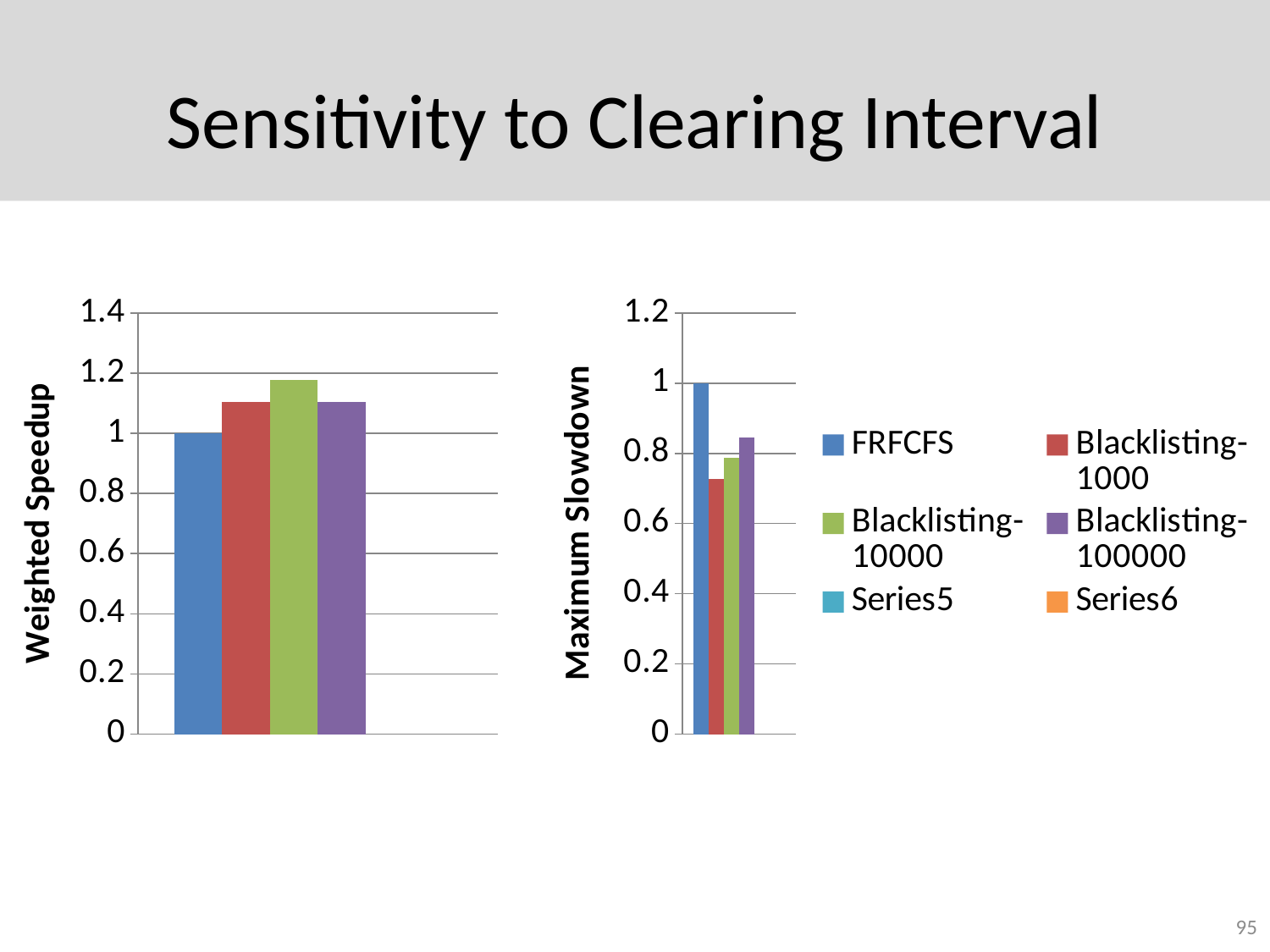
What kind of chart is the Weighted Speedup chart on the left? bar chart In the Maximum Slowdown chart on the right, which is larger, the value for FRFCFS or the value for Blacklisting-10000? FRFCFS In the Maximum Slowdown chart on the right, which series has the lowest value? Blacklisting-1000 In the Weighted Speedup chart on the left, which series has the highest value? Blacklisting-10000 In the Maximum Slowdown chart on the right, is the value for Blacklisting-1000 greater or less than 0.6? greater In the Weighted Speedup chart on the left, which series has the lowest value? FRFCFS How many series does the legend list? 6 What is the y-axis label of the chart on the right? Maximum Slowdown In the Maximum Slowdown chart on the right, which series has the highest value? FRFCFS In the Weighted Speedup chart on the left, is the value for Blacklisting-1000 greater or less than 1.2? less In the Maximum Slowdown chart on the right, is the value for Blacklisting-100000 greater or less than 1? less